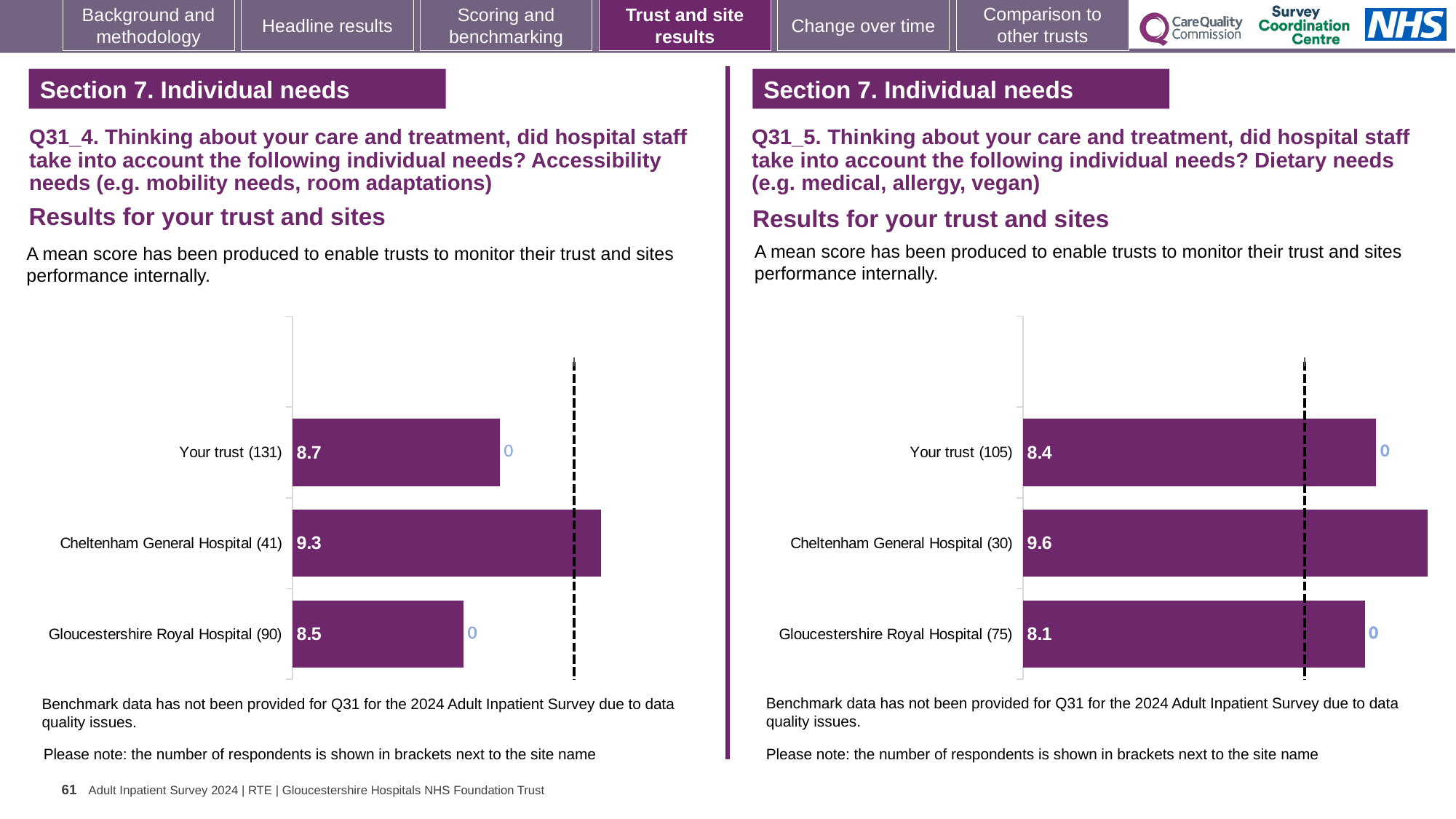
On the left chart (Q31_4, accessibility needs), which site or trust has the highest mean score? Cheltenham General Hospital On the right chart (Q31_5, dietary needs), what is the difference between the mean scores of Cheltenham General Hospital and Your trust? 1.2 On the left chart (Q31_4, accessibility needs), what is the mean score for Your trust? 8.7 On the left chart (Q31_4, accessibility needs), what is the difference between the mean scores of Cheltenham General Hospital and Gloucestershire Royal Hospital? 0.8 On the left chart (Q31_4, accessibility needs), what is the mean score for Cheltenham General Hospital? 9.3 On the right chart (Q31_5, dietary needs), which has the larger mean score: Your trust or Gloucestershire Royal Hospital? Your trust On the right chart (Q31_5, dietary needs), what is the mean score for Gloucestershire Royal Hospital? 8.1 On the right chart (Q31_5, dietary needs), which site or trust has the lowest mean score? Gloucestershire Royal Hospital How many bars are shown on the left chart (Q31_4, accessibility needs)? 3 What type of chart is used on the right (Q31_5, dietary needs)? Bar chart On the right chart (Q31_5, dietary needs), what is the mean score for Cheltenham General Hospital? 9.6 On the right chart (Q31_5, dietary needs), how many respondents are shown in brackets for Your trust? 105